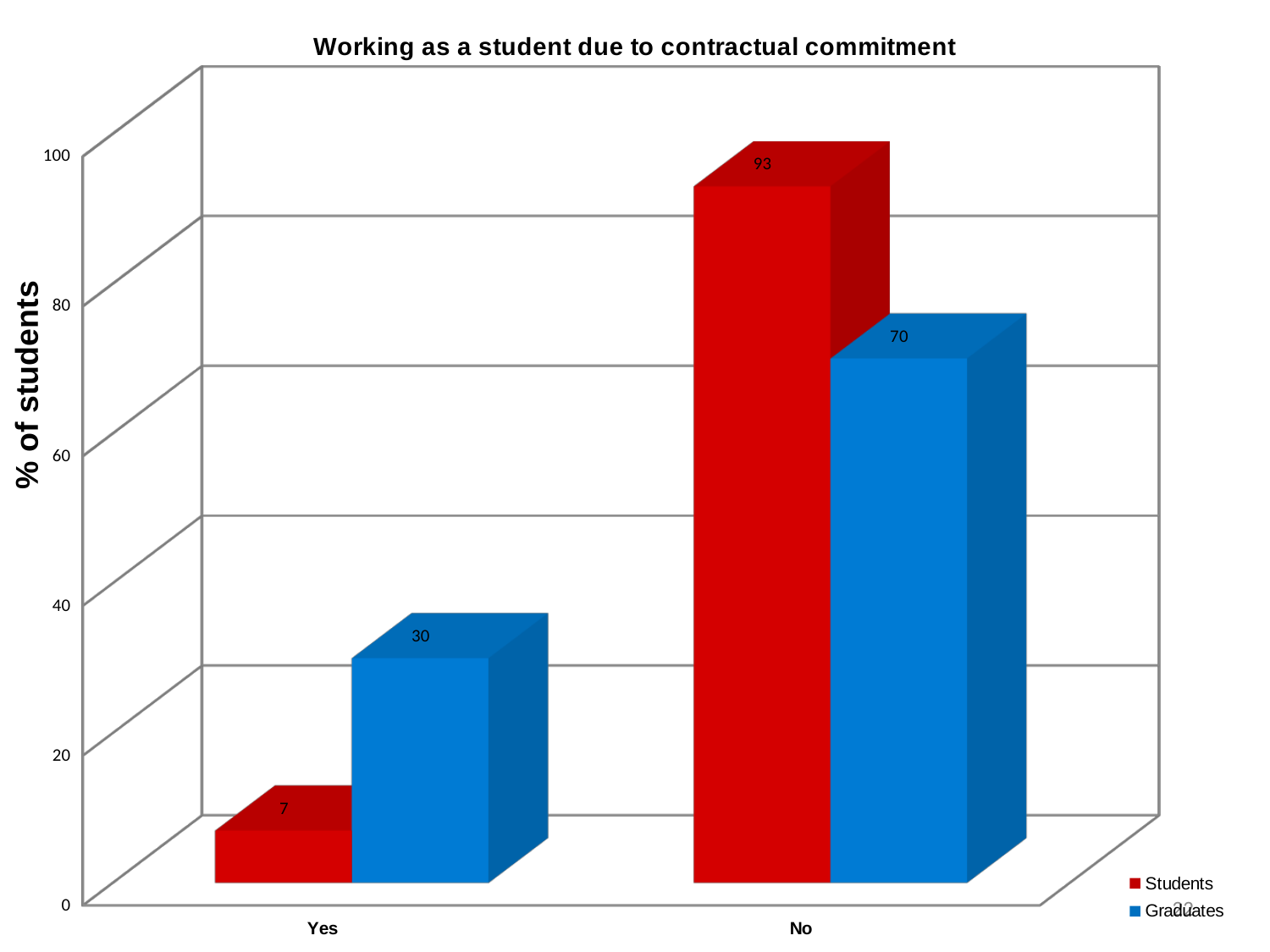
How many series does the legend list? 2 What is the value for Students in the No category? 93 What is the difference between the Students and Graduates values in the No category? 23 What is the title of the chart? Working as a student due to contractual commitment What kind of chart is shown on the slide? Bar chart Which category has the highest value for the Students series? No What is the value for Graduates in the Yes category? 30 What is the value for Students in the Yes category? 7 Which category has the lowest value for the Graduates series? Yes What is the value for Graduates in the No category? 70 What is the difference between the Graduates and Students values in the Yes category? 23 In the Yes category, which series has the larger value, Students or Graduates? Graduates